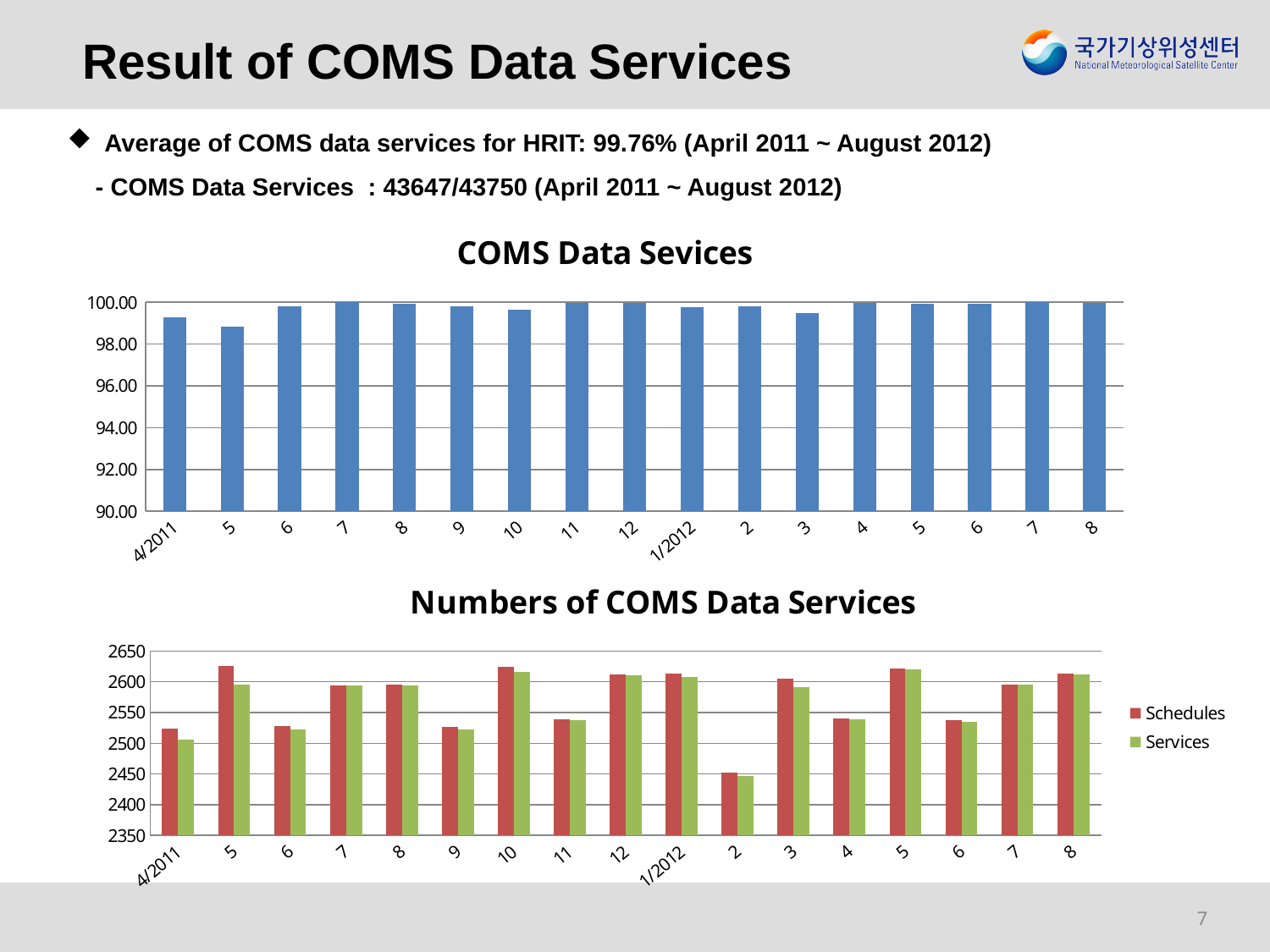
How many series does the legend of the 'Numbers of COMS Data Services' chart list? 2 In the 'Numbers of COMS Data Services' chart, is the Schedules value for 2 greater or less than 2500? less How many categories are shown on the x axis of the 'Numbers of COMS Data Services' chart? 17 In the 'Numbers of COMS Data Services' chart, which colour represents the Services series? green In the 'Numbers of COMS Data Services' chart, which is larger, the Schedules value for 2 or the Schedules value for 3? 3 In the 'Numbers of COMS Data Services' chart, which category has the lowest Schedules value? 2 In the 'COMS Data Sevices' chart, which is larger, the value for 4/2011 or the value for 5? 4/2011 In the 'Numbers of COMS Data Services' chart, is the Services value for 10 greater or less than 2600? greater In the 'COMS Data Sevices' chart, which category has the lowest value? 5 What kind of chart is the 'COMS Data Sevices' chart at the top of the slide? bar chart In the 'Numbers of COMS Data Services' chart, is the Services value for 4/2011 greater or less than 2550? less